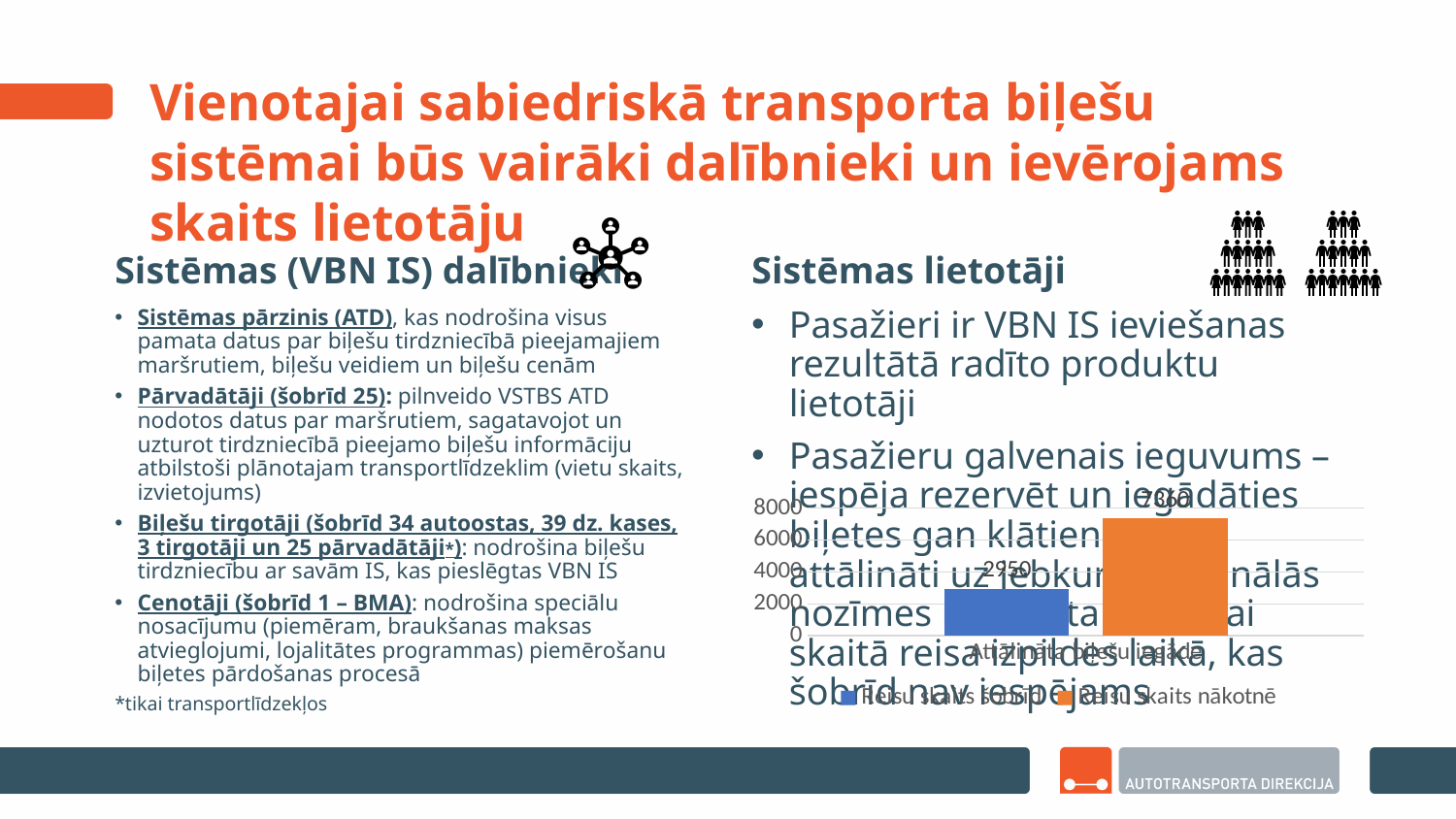
What kind of chart is shown on the slide? bar chart What is the value for 'Reisu skaits šobrīd'? 2950 Is the value for 'Reisu skaits nākotnē' greater or less than 6000? greater Which series has the lowest value in the chart? Reisu skaits šobrīd What is the highest value shown on the chart's vertical axis? 8000 What are the two series named in the chart legend? Reisu skaits šobrīd; Reisu skaits nākotnē How many series does the chart legend list? 2 What is the difference between 'Reisu skaits nākotnē' and 'Reisu skaits šobrīd'? 4410 Which series has the higher value, 'Reisu skaits šobrīd' or 'Reisu skaits nākotnē'? Reisu skaits nākotnē Is the value for 'Reisu skaits šobrīd' greater or less than 4000? less Which colour is used for the 'Reisu skaits nākotnē' bar? orange What is the value for 'Reisu skaits nākotnē'? 7360